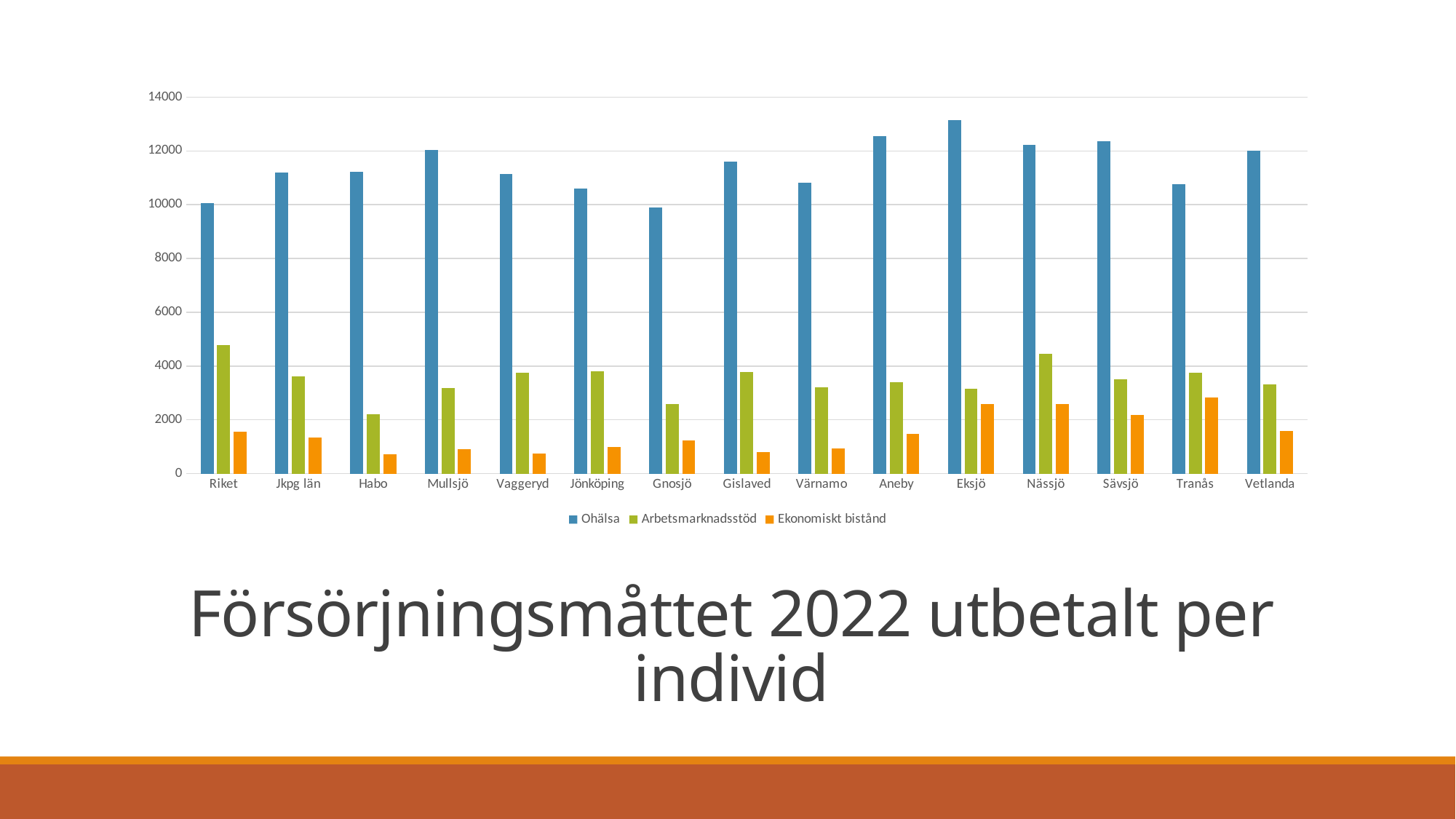
How many categories are shown on the x axis? 15 How many series does the legend list? 3 Is the Ekonomiskt bistånd value for Habo greater or less than 2000? less Which category has the lowest Arbetsmarknadsstöd value? Habo Is the Arbetsmarknadsstöd value for Riket greater or less than 4000? greater Which category has the highest Arbetsmarknadsstöd value? Riket What is the title shown below the chart? Försörjningsmåttet 2022 utbetalt per individ Which category has the highest Ohälsa value? Eksjö What kind of chart is shown on the slide? Bar chart Which has the larger Ekonomiskt bistånd value, Nässjö or Habo? Nässjö Which has the larger Ohälsa value, Aneby or Värnamo? Aneby Is the Ohälsa value for Eksjö greater or less than 12000? greater